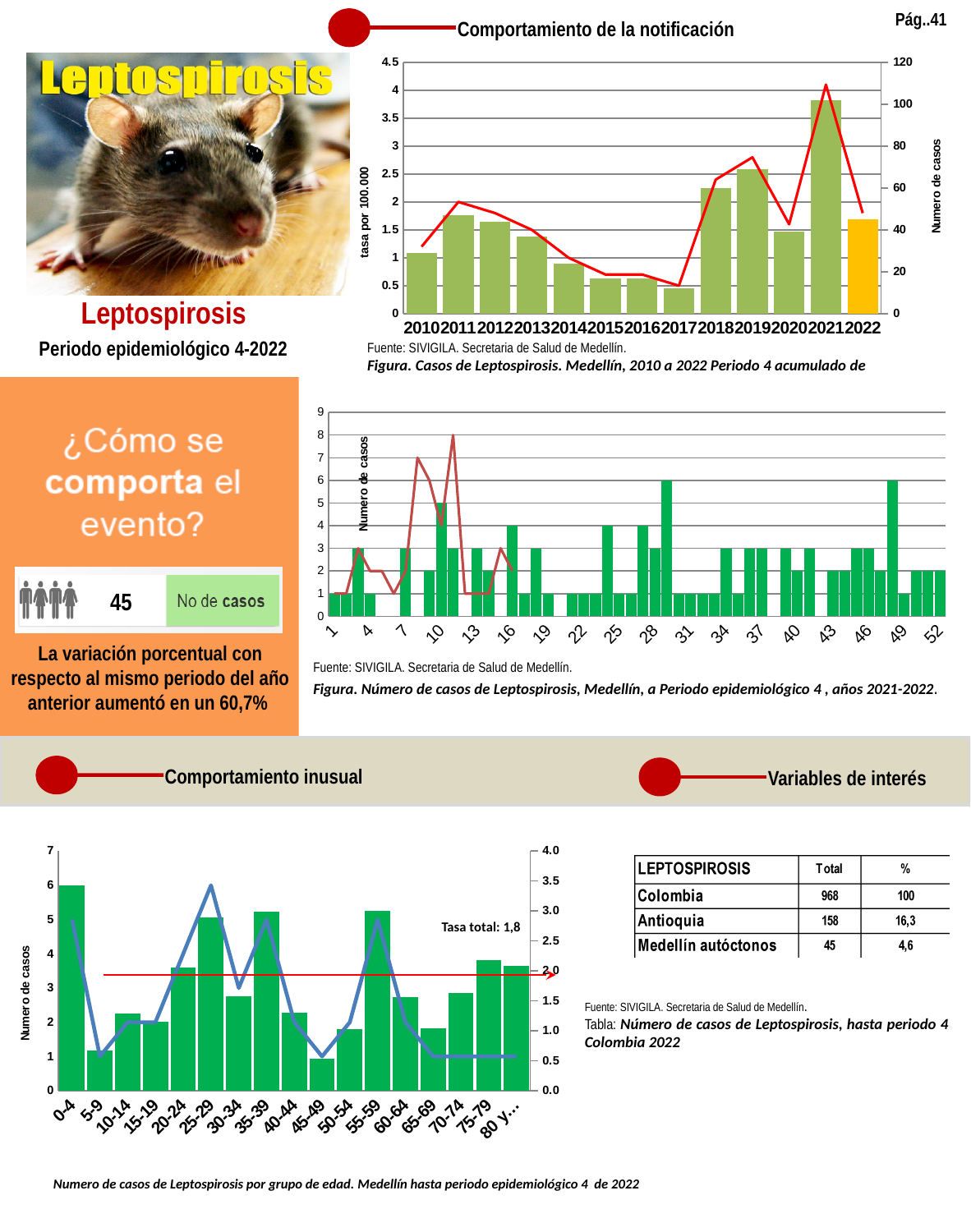
In the top-right chart 'Casos de Leptospirosis. Medellín, 2010 a 2022', which year has the tallest bar? 2021 In the top-right chart 'Casos de Leptospirosis. Medellín, 2010 a 2022', which bar is taller, 2018 or 2013? 2018 In the top-right chart 'Casos de Leptospirosis. Medellín, 2010 a 2022', which year's bar is coloured orange instead of green? 2022 In the middle chart 'Número de casos de Leptospirosis, Medellín, a Periodo epidemiológico 4, años 2021-2022', is the bar for week 10 greater or less than 4? greater In the bottom-left chart of cases by age group, which age group has the shortest bar? 45-49 In the top-right chart 'Casos de Leptospirosis. Medellín, 2010 a 2022', how many years are shown on the x axis? 13 In the bottom-left chart of cases by age group, what is the 'Tasa total' value printed on the chart? 1,8 In the bottom-left chart of cases by age group, which age group has the tallest bar? 0-4 In the top-right chart 'Casos de Leptospirosis. Medellín, 2010 a 2022', what kind of chart is it? Bar chart with a line In the top-right chart 'Casos de Leptospirosis. Medellín, 2010 a 2022', which year has the shortest bar? 2017